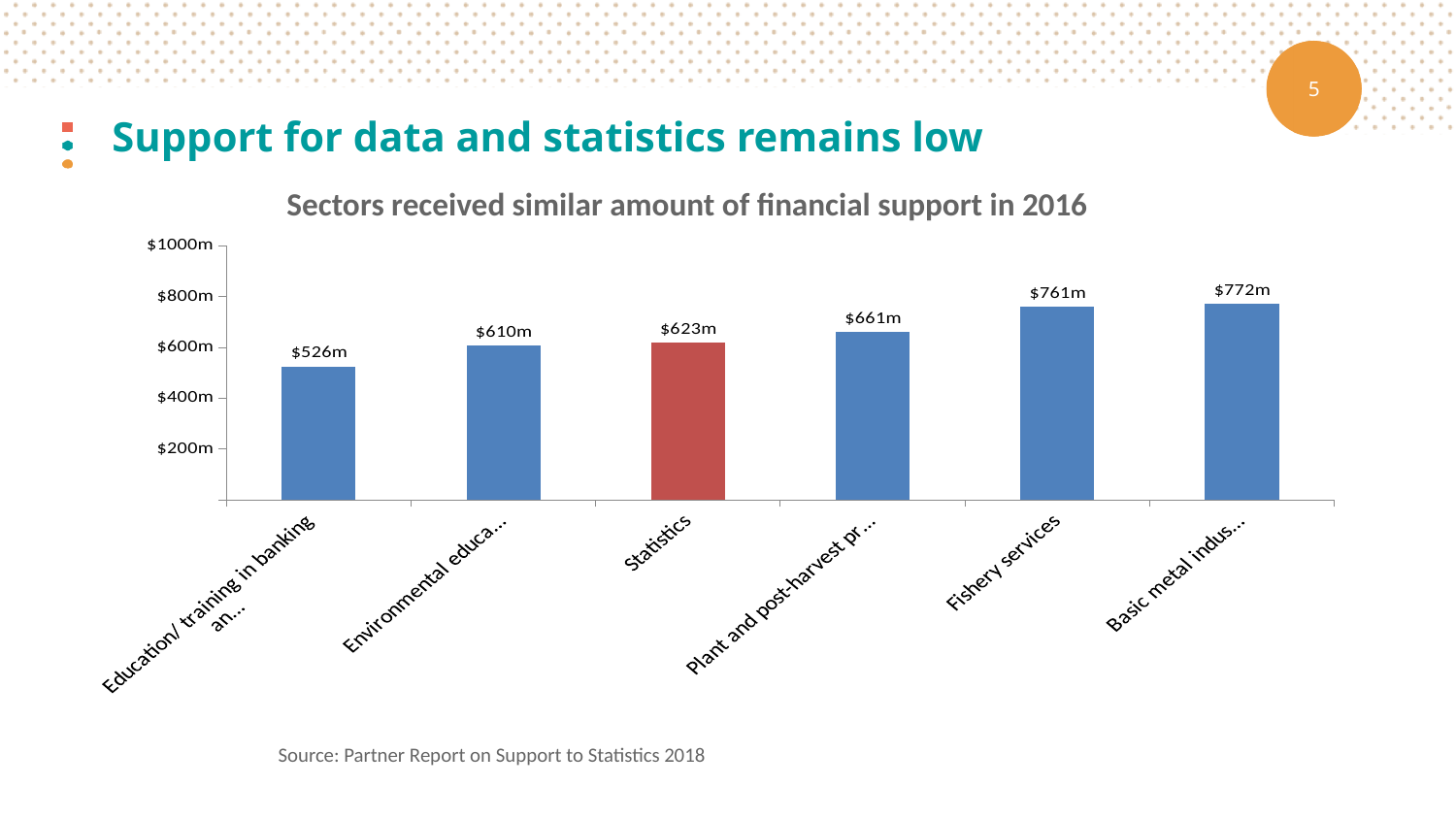
What is the value for Statistics? $623m Is the value for Statistics greater or less than $800m? less What is the value of the rightmost bar in the chart? $772m What is the title of the chart? Sectors received similar amount of financial support in 2016 What is the value for Fishery services? $761m What kind of chart is shown on the slide? bar chart How many bars are shown in the chart? 6 Which category has the lowest value? Education/ training in banking Do the values rise or fall from left to right across the chart? rise Which is larger, the value for Statistics or the value for Fishery services? Fishery services What is the value of the leftmost bar (Education/ training in banking)? $526m What is the difference between Fishery services and Statistics? $138m